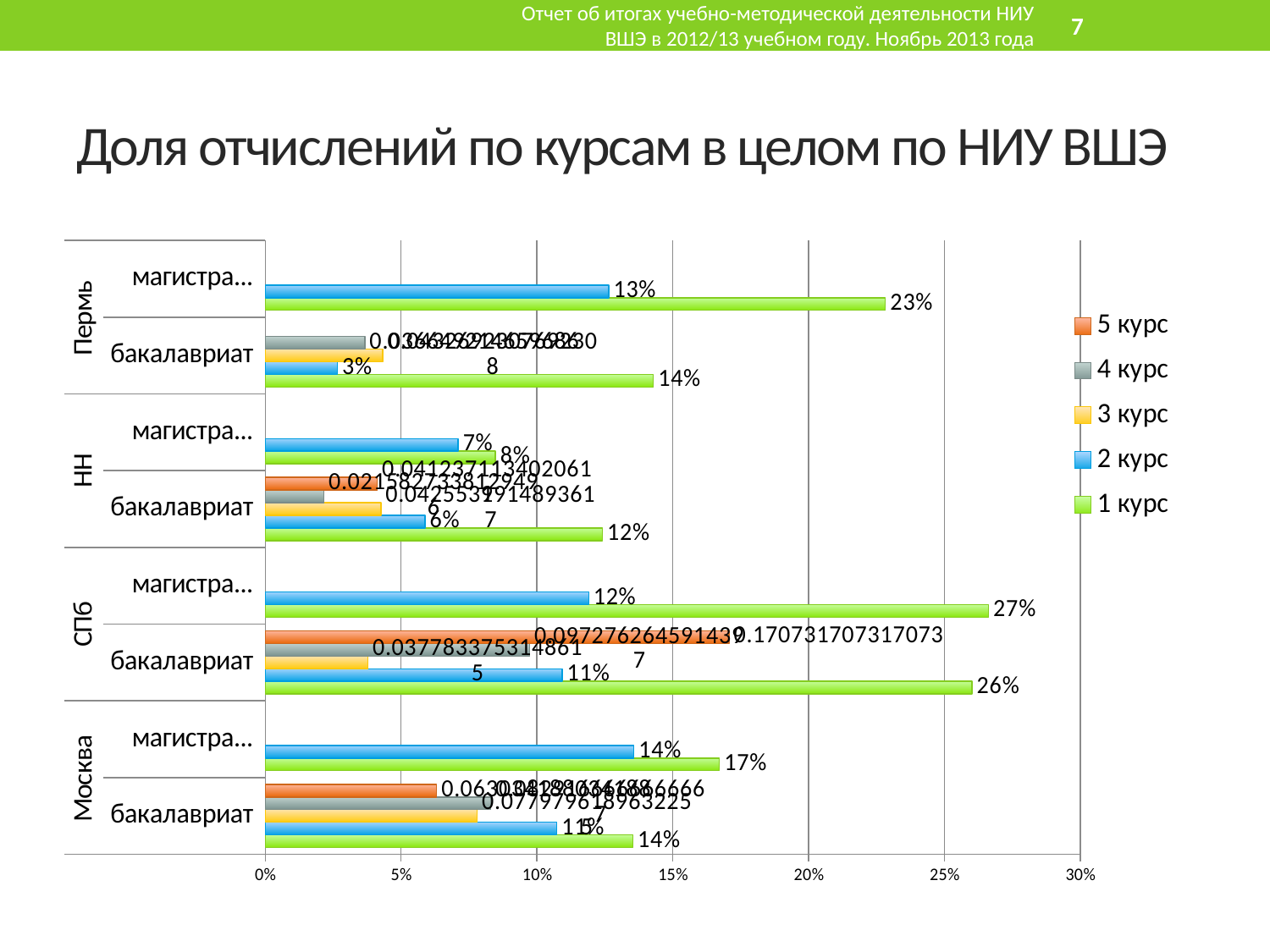
What kind of chart is shown on the slide? bar chart How many series does the legend list? 5 Which is larger: the 1 курс value for магистратура in СПб or the 1 курс value for магистратура in Москва? СПб What is the difference between the 1 курс and 2 курс values in the магистратура group for Пермь? 10% What is the value for 2 курс in the магистратура group for Пермь? 13% What is the value for 1 курс in the магистратура group for Пермь? 23% What is the value for 1 курс in the магистратура group for СПб? 27% What is the value for 1 курс in the магистратура group for Москва? 17% What is the value for 1 курс in the бакалавриат group for СПб? 26% What is the value for 2 курс in the бакалавриат group for НН? 6% Is the 1 курс value for бакалавриат in Пермь greater or less than 10%? greater Which series is shown in green in the legend? 1 курс